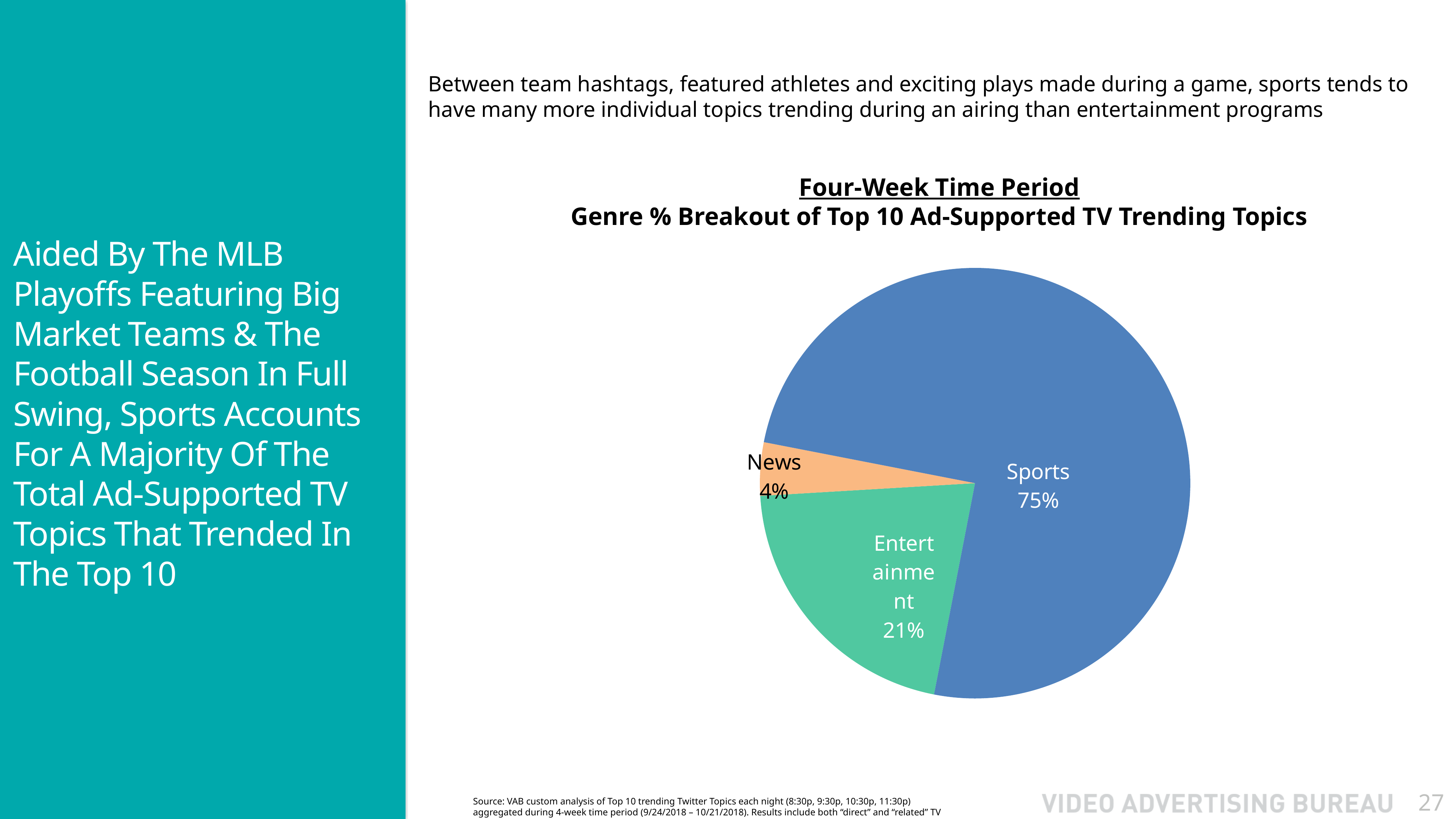
Which genre has the largest share of the pie? Sports What colour is the Sports slice of the pie chart? Blue What percentage of the pie does News account for? 4% What is the difference in percentage points between the Entertainment and News slices? 17 How many slices does the pie chart have? 3 What percentage of the pie does Sports account for? 75% What percentage of the pie does Entertainment account for? 21% What kind of chart is shown on the slide? Pie chart Which slice is larger, Entertainment or News? Entertainment What is the difference in percentage points between the Sports and Entertainment slices? 54 What is the title of the pie chart? Four-Week Time Period Genre % Breakout of Top 10 Ad-Supported TV Trending Topics Which genre has the smallest share of the pie? News